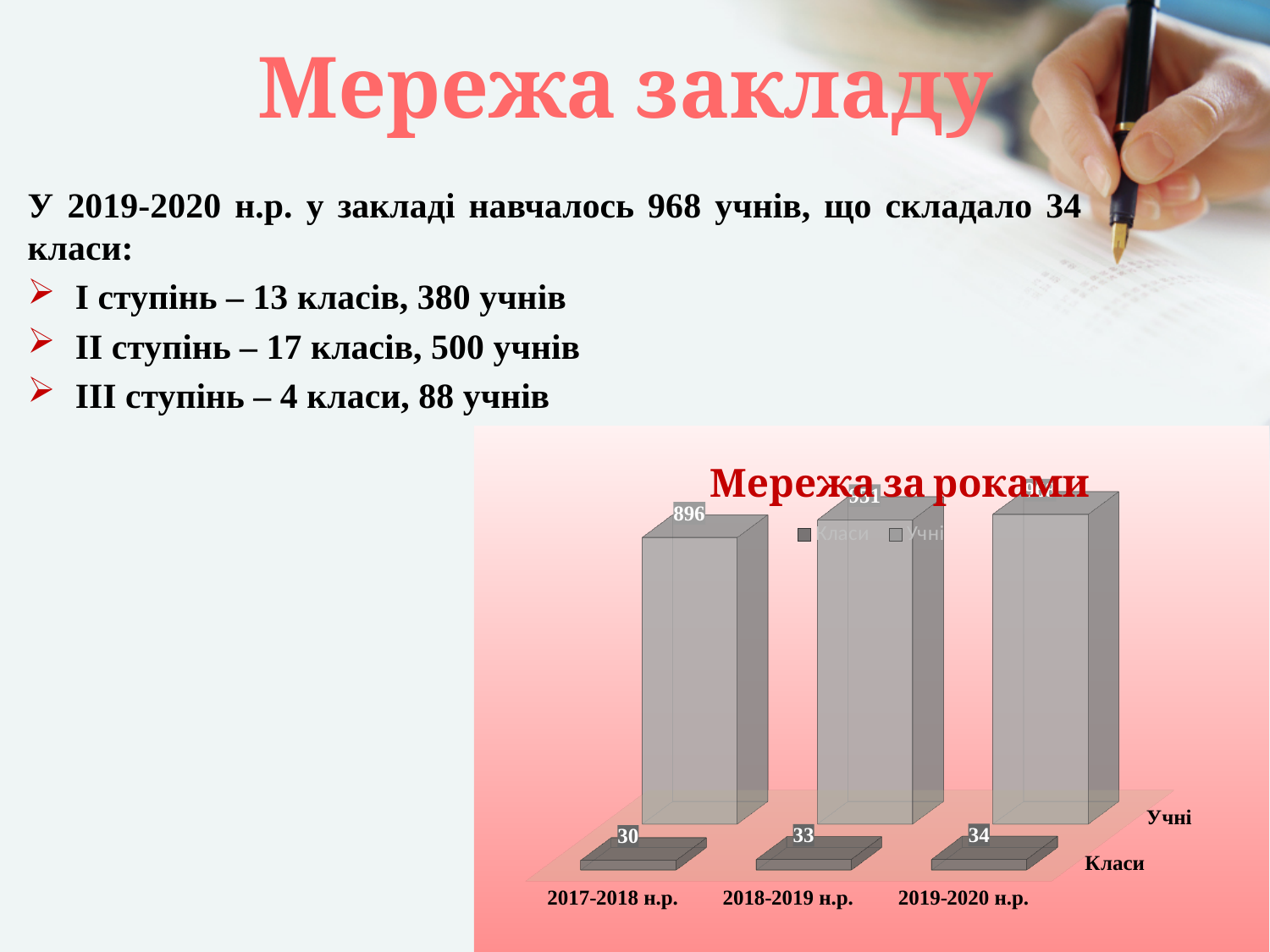
In the chart 'Мережа за роками', do the values of Класи rise or fall from 2017-2018 н.р. to 2019-2020 н.р.? Rise In the chart 'Мережа за роками', what is the value of Учні for 2017-2018 н.р.? 896 In the chart 'Мережа за роками', which year has the highest value of Класи? 2019-2020 н.р. What type of chart is 'Мережа за роками'? Bar chart In the chart 'Мережа за роками', what is the value of Класи for 2017-2018 н.р.? 30 In the chart 'Мережа за роками', what is the difference in Класи between 2019-2020 н.р. and 2017-2018 н.р.? 4 In the chart 'Мережа за роками', what is the value of Класи for 2018-2019 н.р.? 33 In the chart 'Мережа за роками', which year has the lowest value of Класи? 2017-2018 н.р. In the chart 'Мережа за роками', what is the value of Класи for 2019-2020 н.р.? 34 In the chart 'Мережа за роками', which year has the larger value of Учні: 2017-2018 н.р. or 2019-2020 н.р.? 2019-2020 н.р. How many series does the legend of the chart 'Мережа за роками' list? 2 How many years (categories) are shown in the chart 'Мережа за роками'? 3